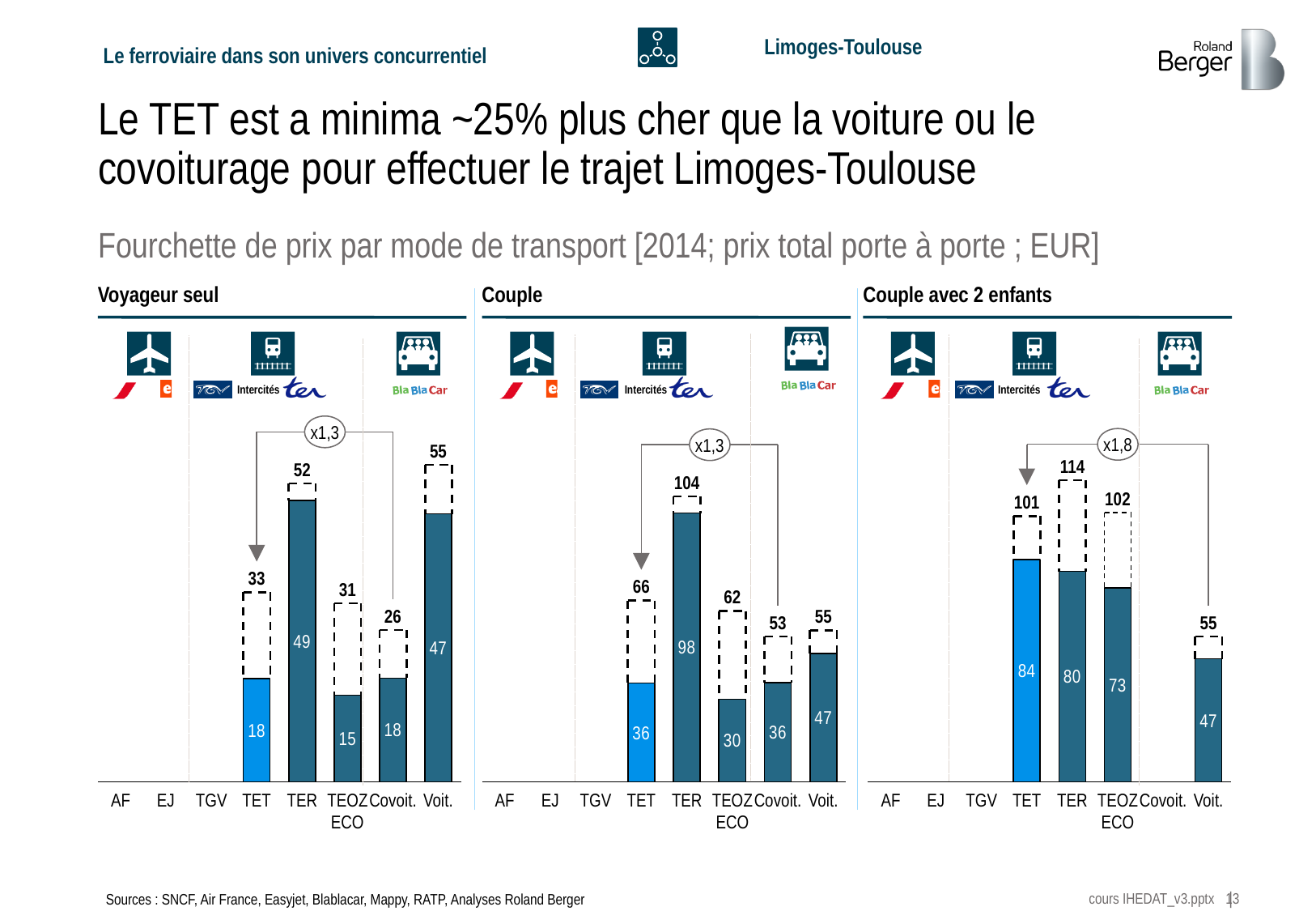
In the 'Couple avec 2 enfants' chart, which mode has the lowest minimum price? Voit. How many category labels are shown on the x axis of the 'Voyageur seul' chart? 8 In the 'Voyageur seul' chart, what is the maximum price shown for TER? 52 In the 'Couple' chart, what is the maximum price shown for TET? 66 In the 'Voyageur seul' chart, what is the minimum price shown for TET? 18 In the 'Couple avec 2 enfants' chart, what is the maximum price shown for TER? 114 In the 'Voyageur seul' chart, what is the difference between the maximum price for Voit. and the maximum price for Covoit.? 29 What kind of chart is used in the 'Couple' panel? bar chart In the 'Couple' chart, which mode has the highest maximum price? TER In the 'Couple avec 2 enfants' chart, is the minimum price for TET larger or smaller than the minimum price for TEOZ ECO? larger In the 'Couple' chart, what is the minimum price shown for TEOZ ECO? 30 In the 'Couple avec 2 enfants' chart, what multiplier is shown between TET and Voit.? x1,8